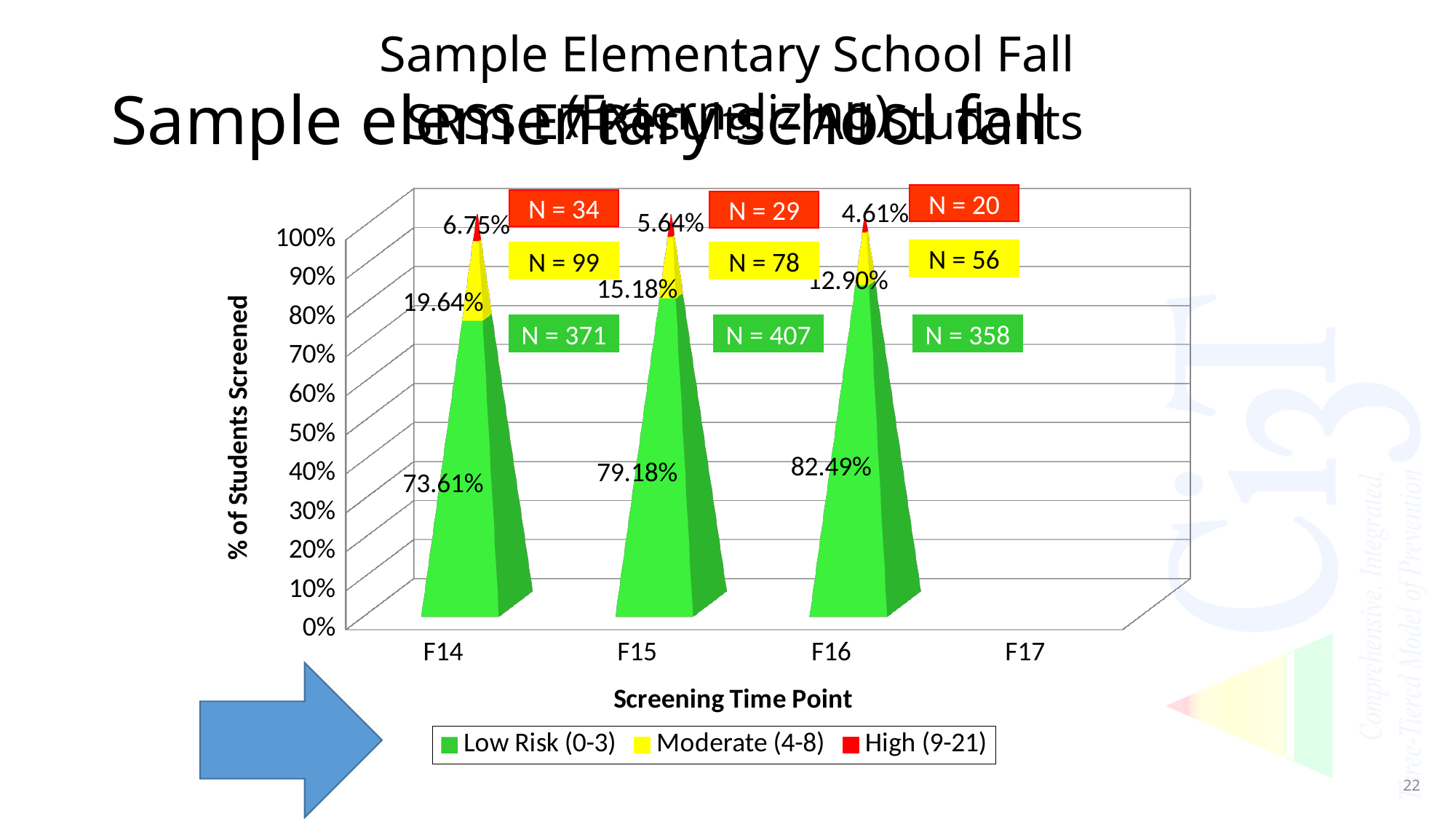
What is the Low Risk (0-3) value for F14? 73.61% Does the Low Risk (0-3) percentage rise or fall from F14 to F16? Rise What is the difference between the Low Risk (0-3) values for F16 and F14? 8.88% What is the High (9-21) value for F16? 4.61% Which screening time point has the highest Low Risk (0-3) percentage? F16 Is the Moderate (4-8) value larger for F14 or F15? F14 Which screening time point has the lowest High (9-21) percentage? F16 What is the label on the vertical axis of the chart? % of Students Screened What kind of chart is shown on the slide? Stacked bar chart How many series does the legend list? 3 What is the Moderate (4-8) value for F16? 12.90% What is the Moderate (4-8) value for F15? 15.18%